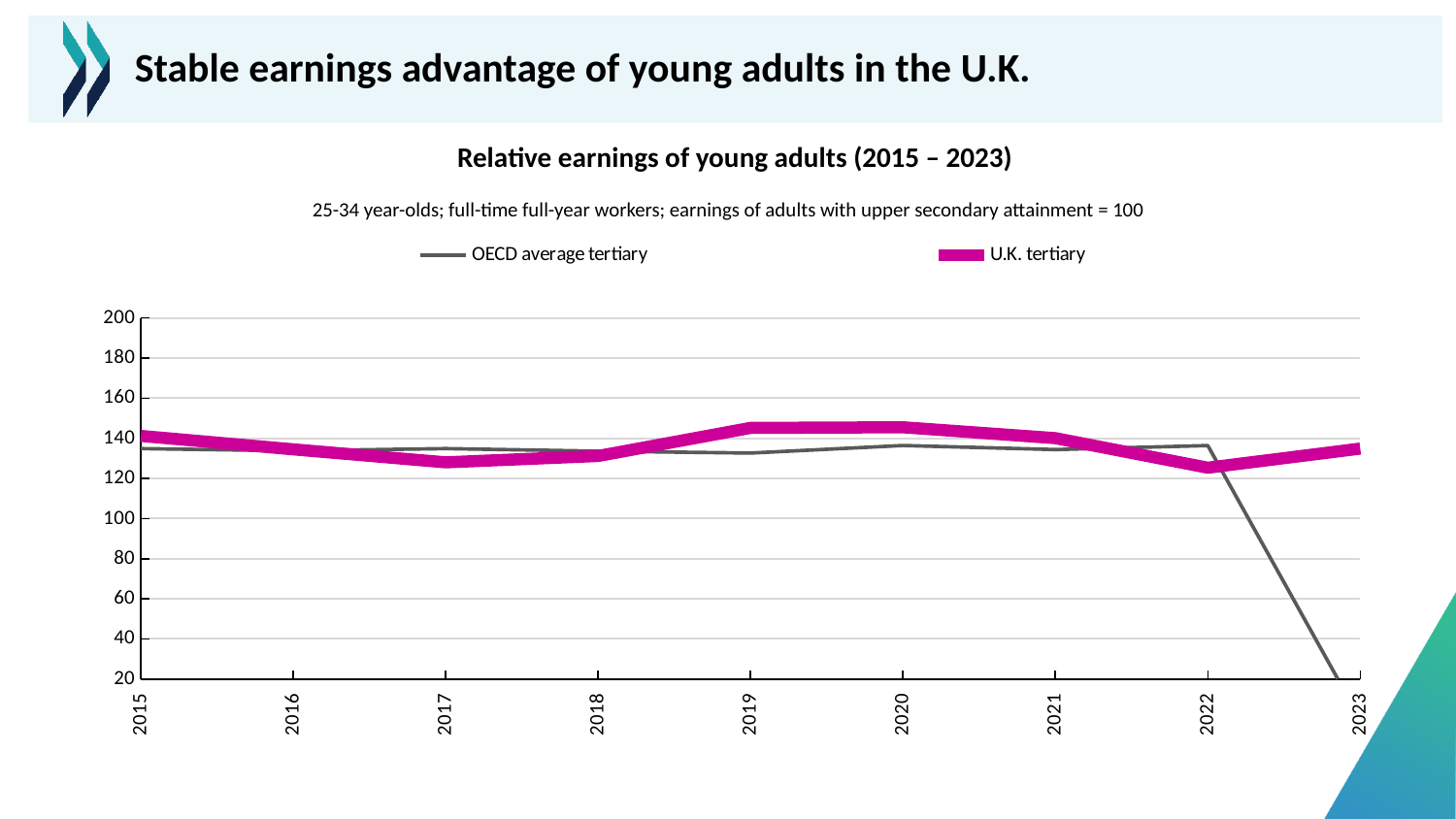
What kind of chart is shown on the slide? line chart What is the title of the chart? Relative earnings of young adults (2015 – 2023) Is the value for OECD average tertiary in 2020 greater or less than 120? greater In 2019, which series has the higher value, OECD average tertiary or U.K. tertiary? U.K. tertiary Does the U.K. tertiary value rise or fall from 2020 to 2022? fall How many series does the legend list? 2 Is the value for U.K. tertiary in 2019 greater or less than 140? greater How many years are shown on the x axis? 9 In 2022, which series has the higher value, OECD average tertiary or U.K. tertiary? OECD average tertiary Is the value for U.K. tertiary in 2017 greater or less than 140? less